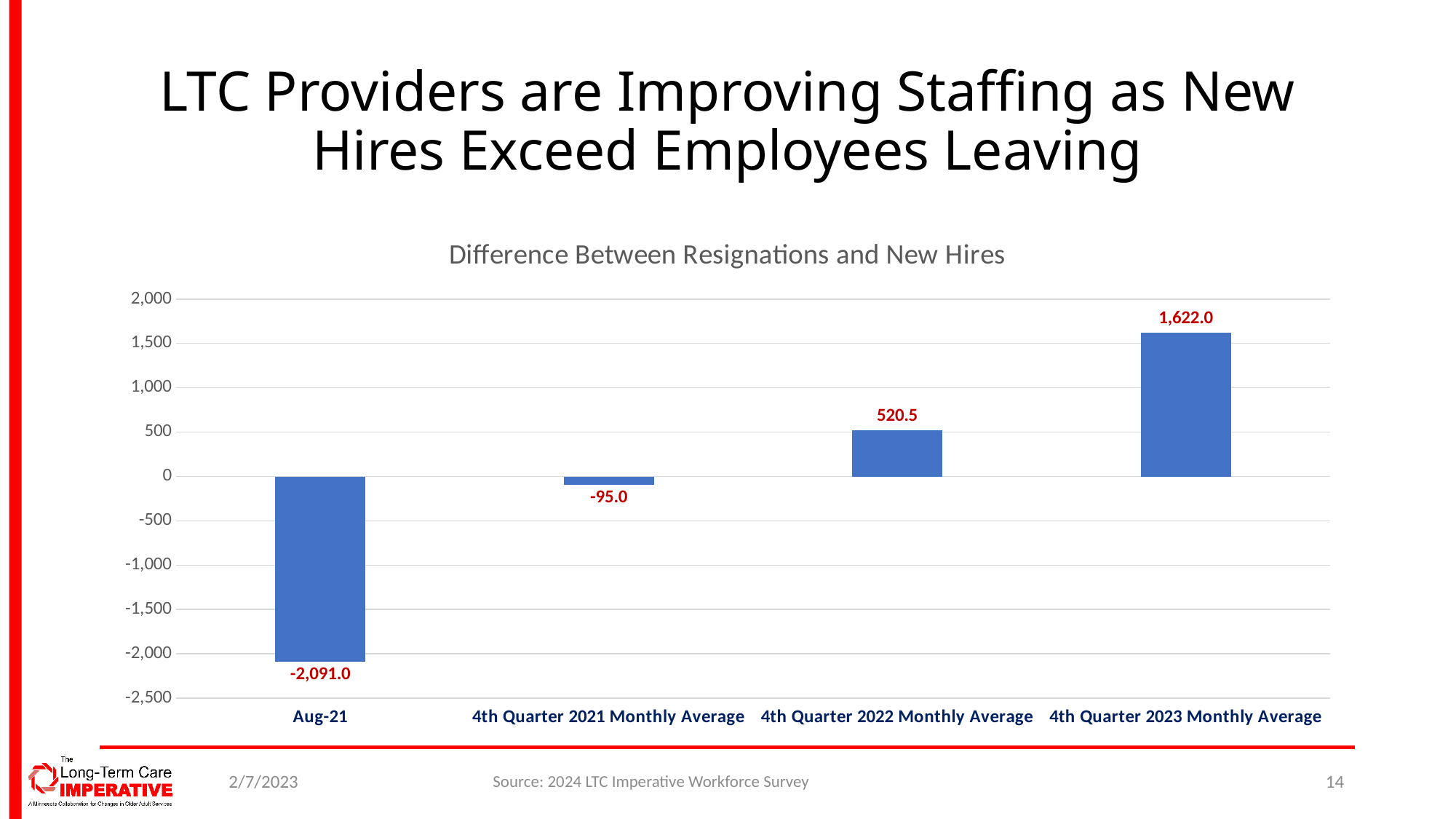
What is the value for 4th Quarter 2023 Monthly Average? 1,622.0 Is the value for 4th Quarter 2023 Monthly Average greater or less than 1,500? greater What kind of chart is shown on the slide? Bar chart What is the difference between the 4th Quarter 2023 Monthly Average and the 4th Quarter 2022 Monthly Average? 1,101.5 Which is larger, the value for 4th Quarter 2022 Monthly Average or the value for 4th Quarter 2021 Monthly Average? 4th Quarter 2022 Monthly Average How many categories are shown on the x axis? 4 What is the value for 4th Quarter 2021 Monthly Average? -95.0 Which category has the highest value? 4th Quarter 2023 Monthly Average Which category has the lowest value? Aug-21 What is the value for 4th Quarter 2022 Monthly Average? 520.5 What is the title of the chart? Difference Between Resignations and New Hires What is the value for Aug-21? -2,091.0